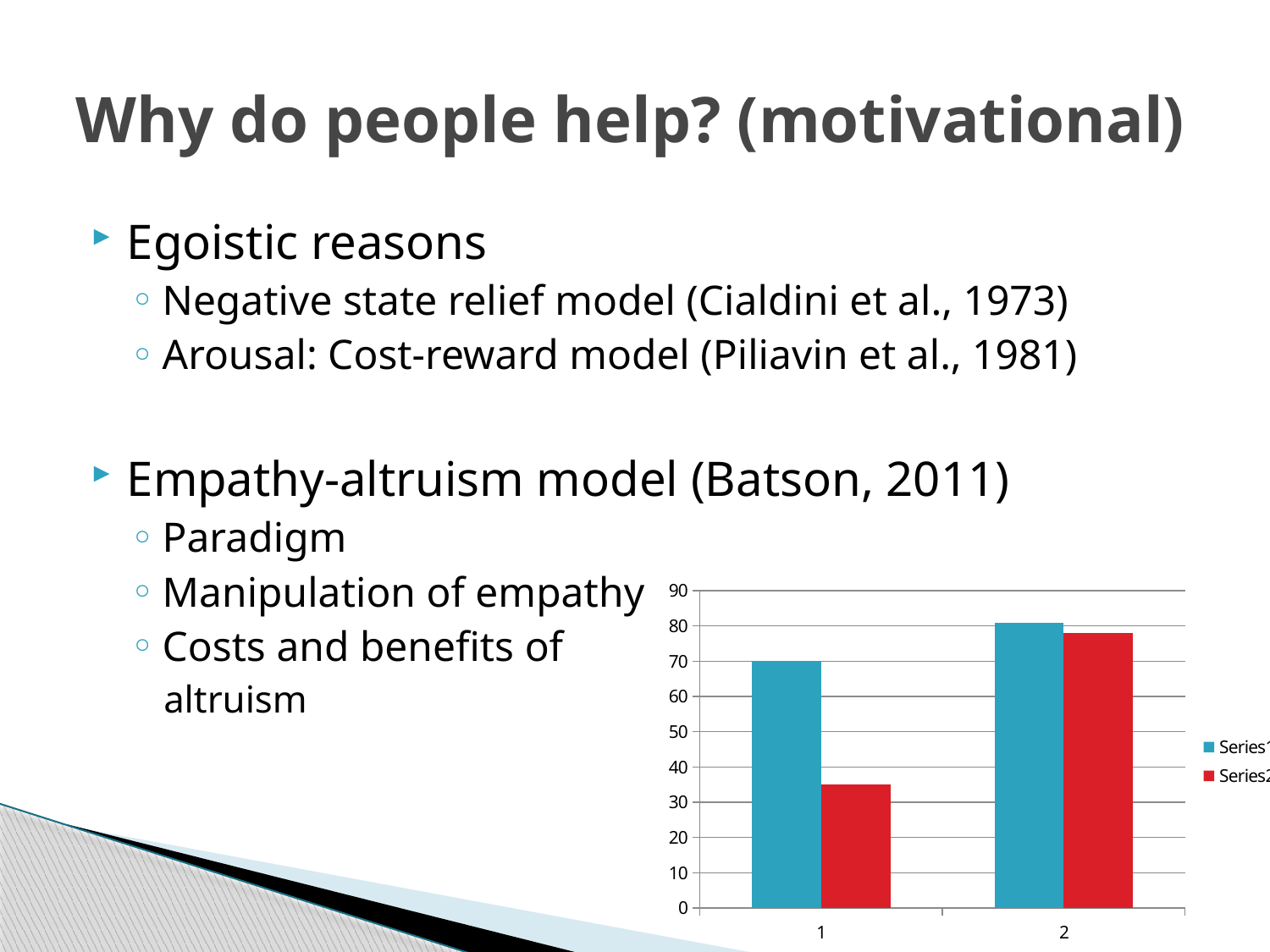
For Series2, which category has the higher value? 2 Does the value of Series2 rise or fall from category 1 to category 2? rise Is the value of Series2 for category 1 greater or less than 40? less Is the value of Series2 for category 2 greater or less than 80? less Which bar is the lowest in the chart? Series2 in category 1 In category 1, which series has the larger value, Series1 or Series2? Series1 What is the value of Series1 for category 1? 70 Is the value of Series2 for category 1 greater or less than 30? greater How many categories are shown on the x axis of the chart? 2 What kind of chart is shown on the slide? bar chart How many series does the chart's legend list? 2